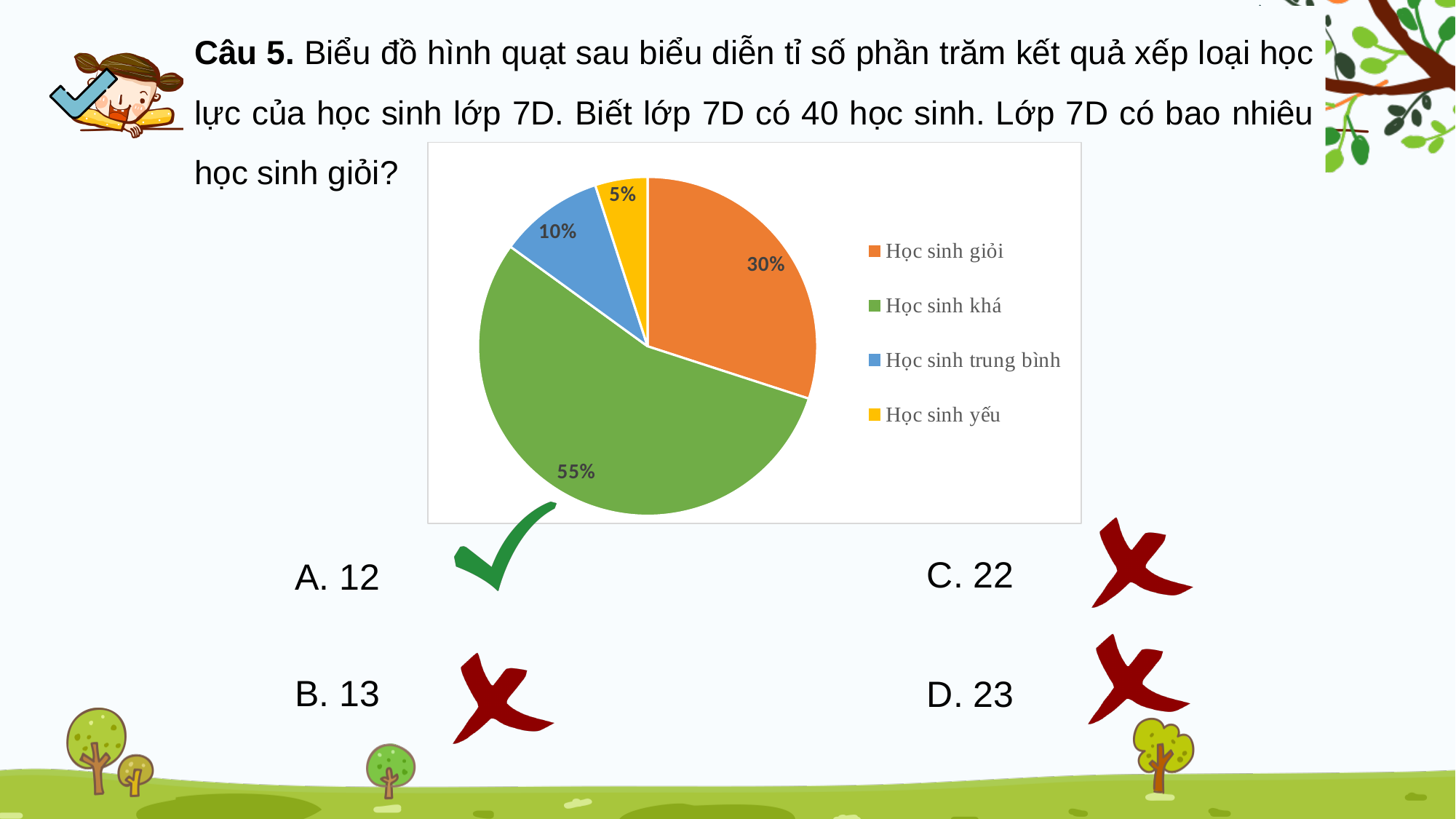
What colour is the slice for Học sinh giỏi? orange What colour is the slice for Học sinh trung bình? blue What percentage of the pie chart is labelled for Học sinh giỏi? 30% What kind of chart is shown on the slide? pie chart What percentage of the pie chart is labelled for Học sinh yếu? 5% Which slice is larger: Học sinh trung bình or Học sinh yếu? Học sinh trung bình What percentage of the pie chart is labelled for Học sinh khá? 55% How many categories does the pie chart show? 4 What percentage of the pie chart is labelled for Học sinh trung bình? 10% Which category has the largest slice of the pie chart? Học sinh khá What is the difference in percentage points between Học sinh khá and Học sinh giỏi? 25% Which category has the smallest slice of the pie chart? Học sinh yếu